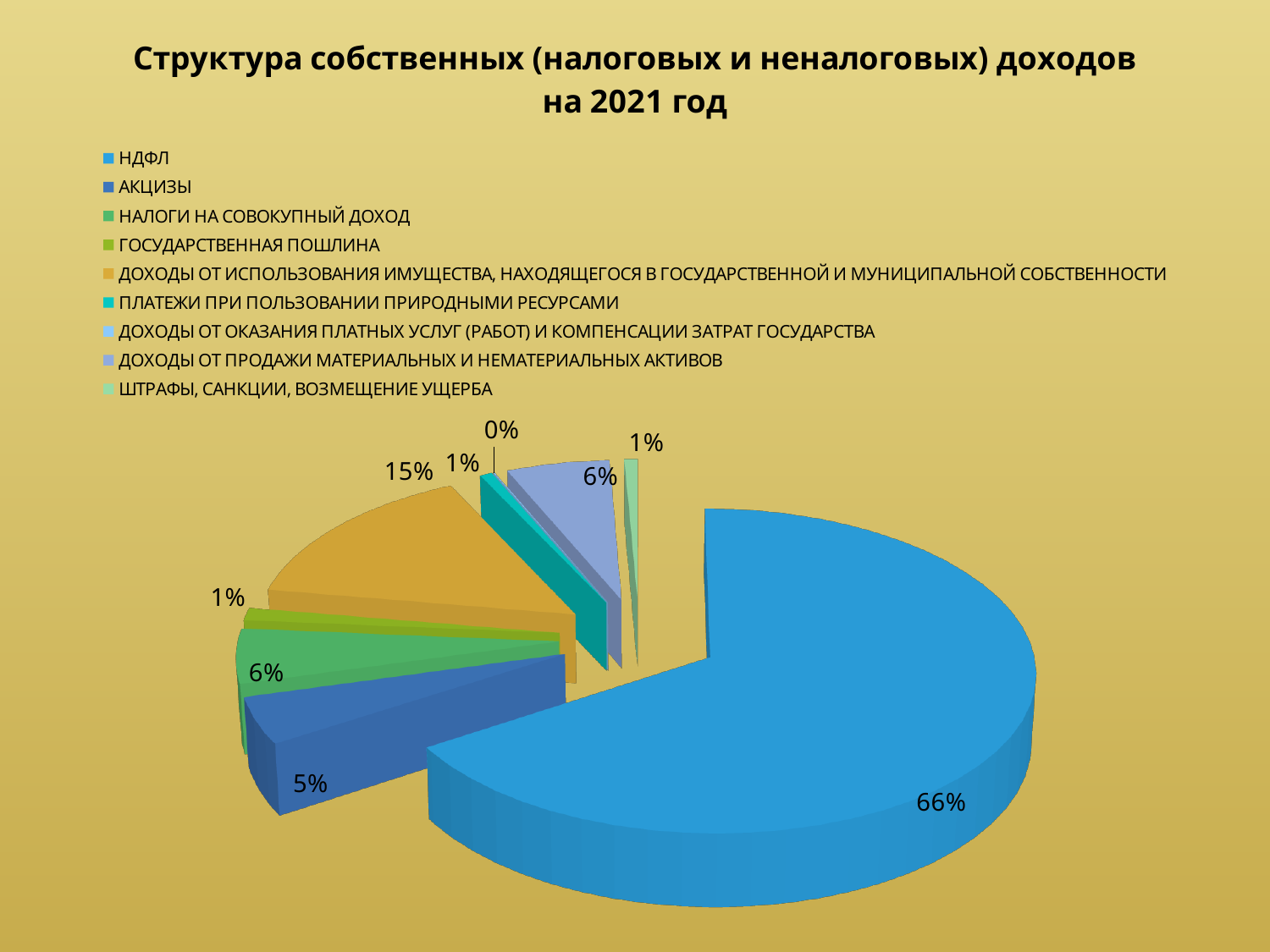
What type of chart is shown on the slide? pie chart What share of the pie does НДФЛ have? 66% What percentage is shown for ДОХОДЫ ОТ ИСПОЛЬЗОВАНИЯ ИМУЩЕСТВА, НАХОДЯЩЕГОСЯ В ГОСУДАРСТВЕННОЙ И МУНИЦИПАЛЬНОЙ СОБСТВЕННОСТИ? 15% What is the difference in percentage points between НДФЛ and ДОХОДЫ ОТ ИСПОЛЬЗОВАНИЯ ИМУЩЕСТВА, НАХОДЯЩЕГОСЯ В ГОСУДАРСТВЕННОЙ И МУНИЦИПАЛЬНОЙ СОБСТВЕННОСТИ? 51% What percentage is shown for НАЛОГИ НА СОВОКУПНЫЙ ДОХОД? 6% How many categories does the legend list? 9 What percentage is shown for АКЦИЗЫ? 5% What percentage is shown for ДОХОДЫ ОТ ОКАЗАНИЯ ПЛАТНЫХ УСЛУГ (РАБОТ) И КОМПЕНСАЦИИ ЗАТРАТ ГОСУДАРСТВА? 0% Which is larger, the share for АКЦИЗЫ or the share for НАЛОГИ НА СОВОКУПНЫЙ ДОХОД? НАЛОГИ НА СОВОКУПНЫЙ ДОХОД Which category has the smallest share of the pie? ДОХОДЫ ОТ ОКАЗАНИЯ ПЛАТНЫХ УСЛУГ (РАБОТ) И КОМПЕНСАЦИИ ЗАТРАТ ГОСУДАРСТВА What is the title of the chart? Структура собственных (налоговых и неналоговых) доходов на 2021 год Which category has the largest share of the pie? НДФЛ